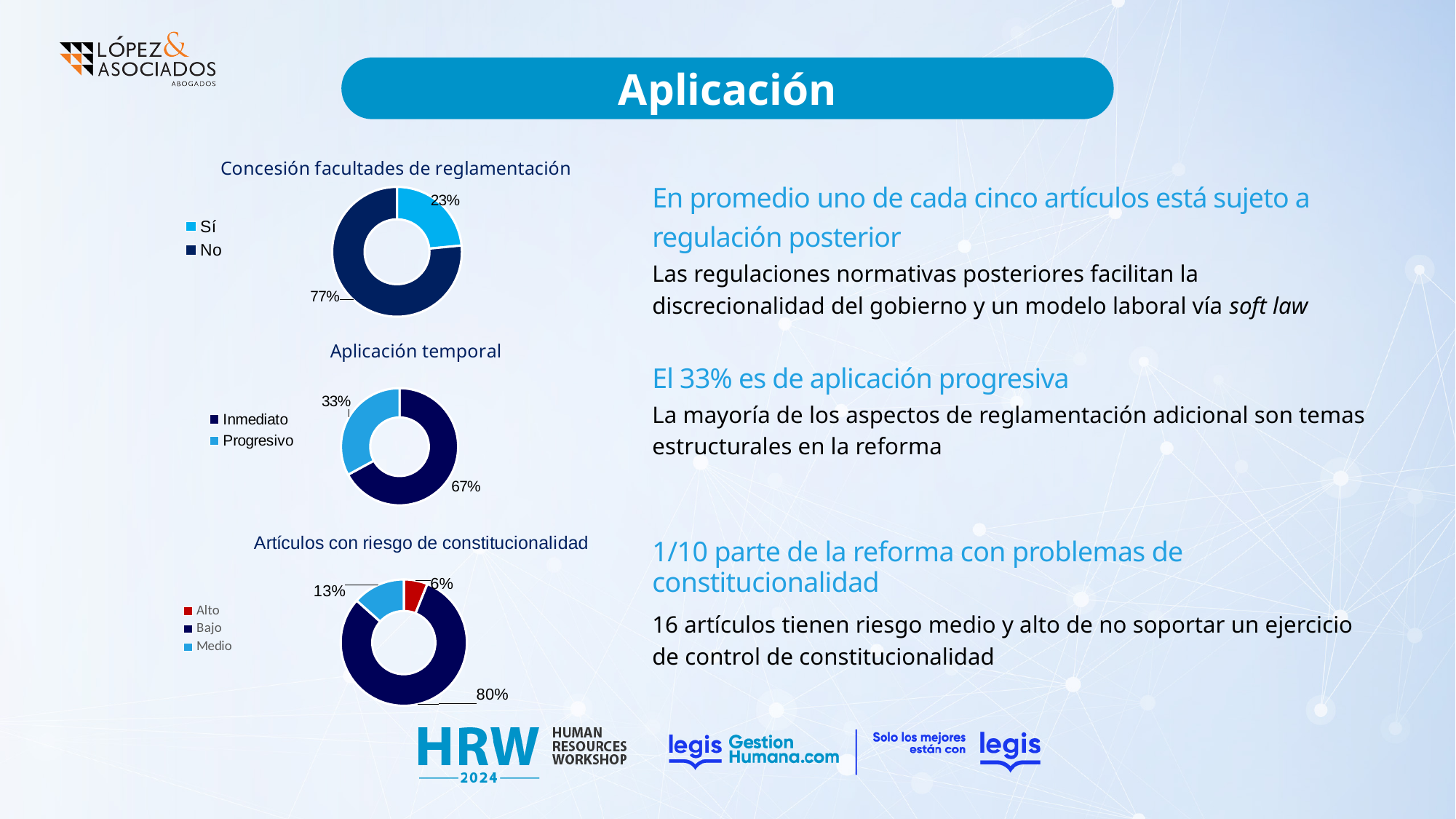
In the 'Concesión facultades de reglamentación' chart, which category has the larger share? No In the 'Aplicación temporal' chart, which is larger, 'Inmediato' or 'Progresivo'? Inmediato In the 'Artículos con riesgo de constitucionalidad' chart, what percentage is shown for 'Alto'? 6% What kind of chart is 'Aplicación temporal'? Doughnut chart In the 'Concesión facultades de reglamentación' chart, what percentage is shown for 'No'? 77% In the 'Aplicación temporal' chart, what percentage is shown for 'Progresivo'? 33% In the 'Artículos con riesgo de constitucionalidad' chart, what percentage is shown for 'Medio'? 13% How many categories does the legend of the 'Artículos con riesgo de constitucionalidad' chart list? 3 In the 'Artículos con riesgo de constitucionalidad' chart, which category has the smallest share? Alto In the 'Concesión facultades de reglamentación' chart, what is the difference between the 'No' and 'Sí' shares? 54 percentage points In the 'Aplicación temporal' chart, what percentage is shown for 'Inmediato'? 67% In the 'Concesión facultades de reglamentación' chart, what percentage is shown for 'Sí'? 23%